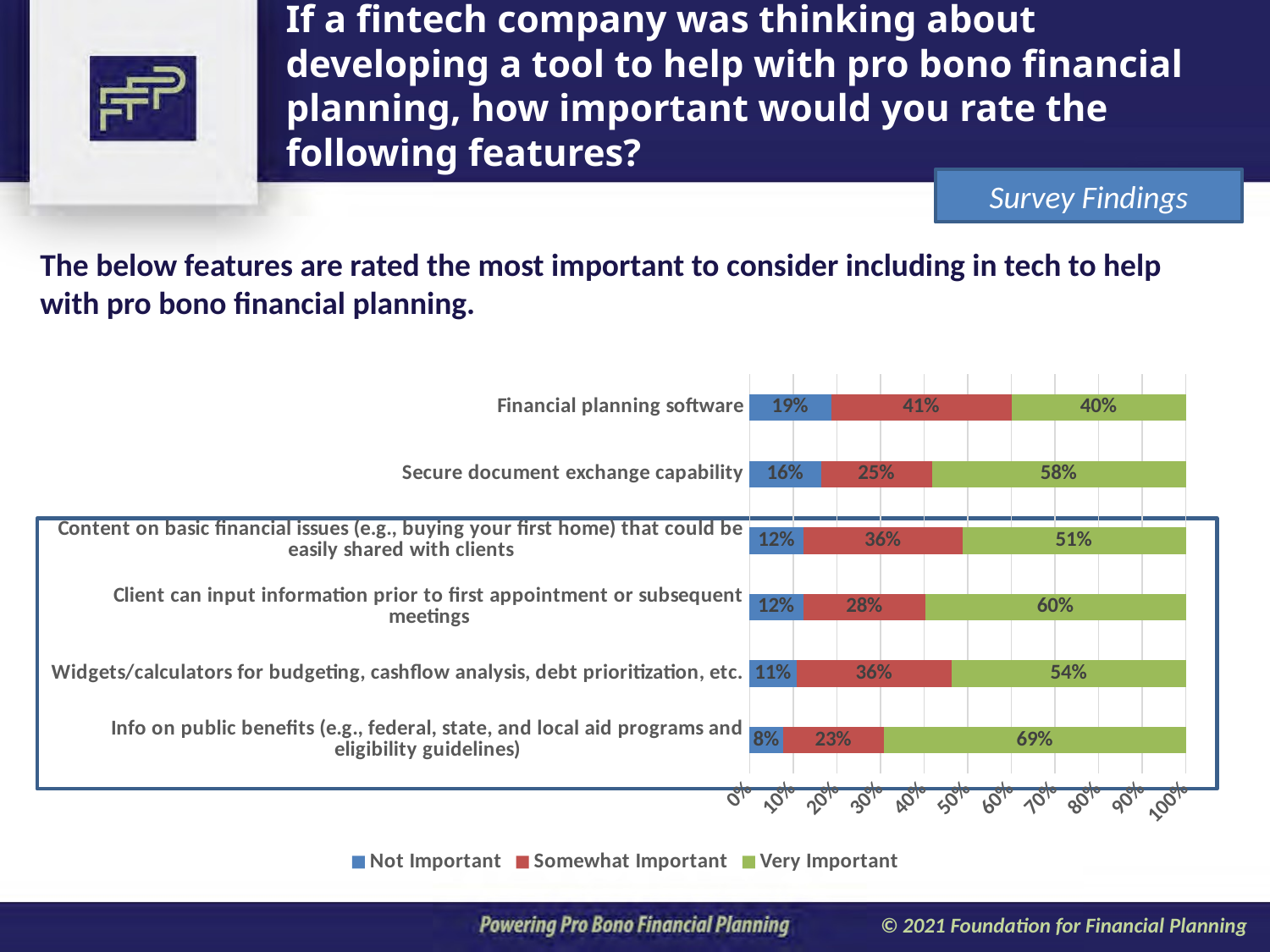
What percentage rated Info on public benefits as Not Important? 8% Which feature has the highest Not Important percentage? Financial planning software What is the difference between the Very Important percentages for Info on public benefits and Financial planning software? 29% Which feature has the highest Very Important percentage? Info on public benefits (e.g., federal, state, and local aid programs and eligibility guidelines) How many series does the legend list? 3 What percentage rated Financial planning software as Very Important? 40% What kind of chart is shown on the slide? Stacked bar chart Which feature has the lowest Very Important percentage? Financial planning software Which is larger: the Somewhat Important percentage for Financial planning software or for Secure document exchange capability? Financial planning software How many features are shown in the chart? 6 What percentage rated Secure document exchange capability as Somewhat Important? 25% What colour represents Very Important in the chart? Green